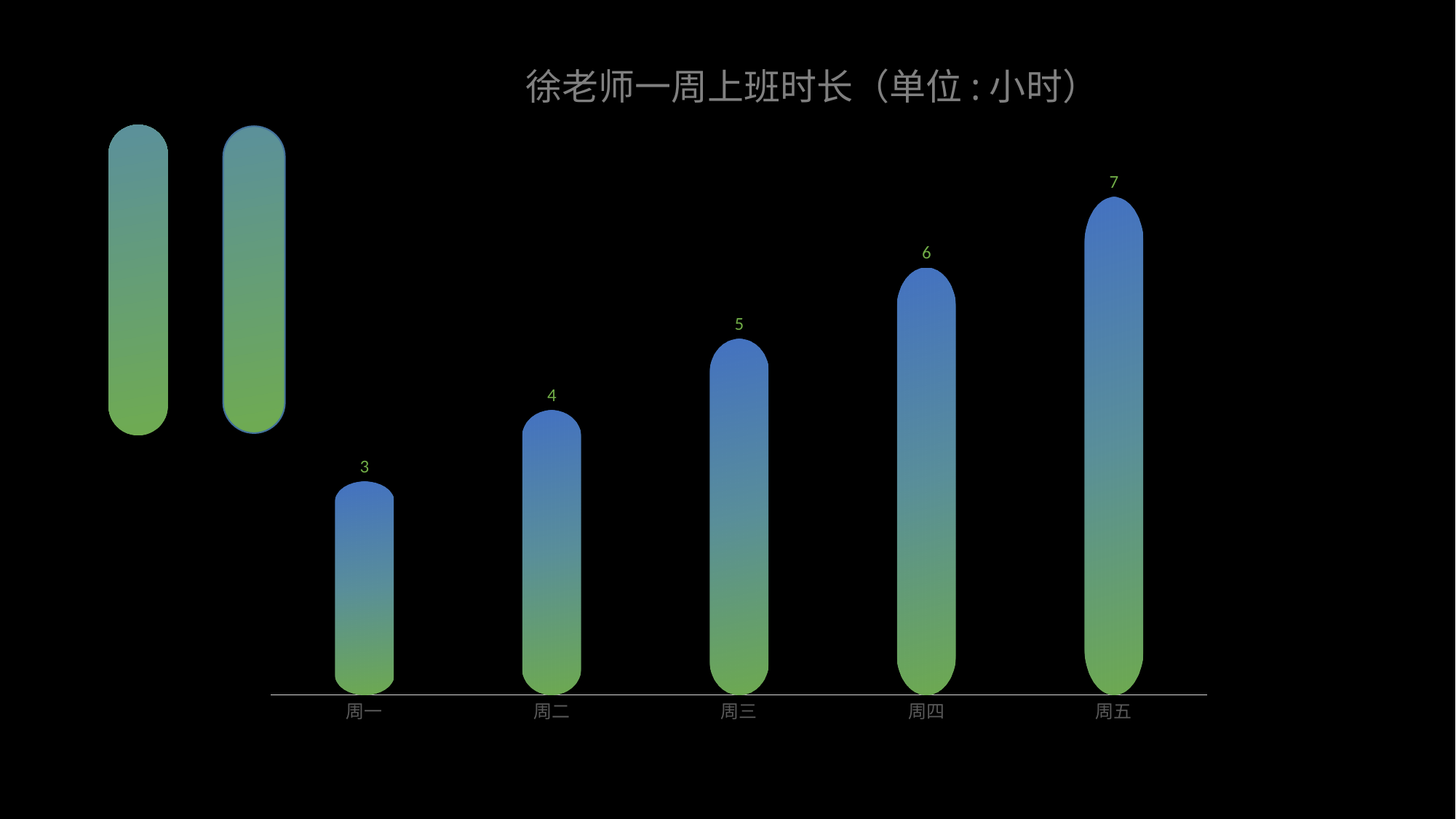
How many days are shown on the x axis? 5 Do the values rise or fall from 周一 to 周五? rise What is the value for 周五? 7 Which day has the lowest value? 周一 What is the difference between the values for 周四 and 周二? 2 What is the value for 周三? 5 What kind of chart is this? bar chart What is the value for 周一? 3 What is the title of the chart? 徐老师一周上班时长（单位：小时） Which day has the highest value? 周五 Which is larger, the value for 周二 or the value for 周四? 周四 What is the difference between the values for 周五 and 周一? 4